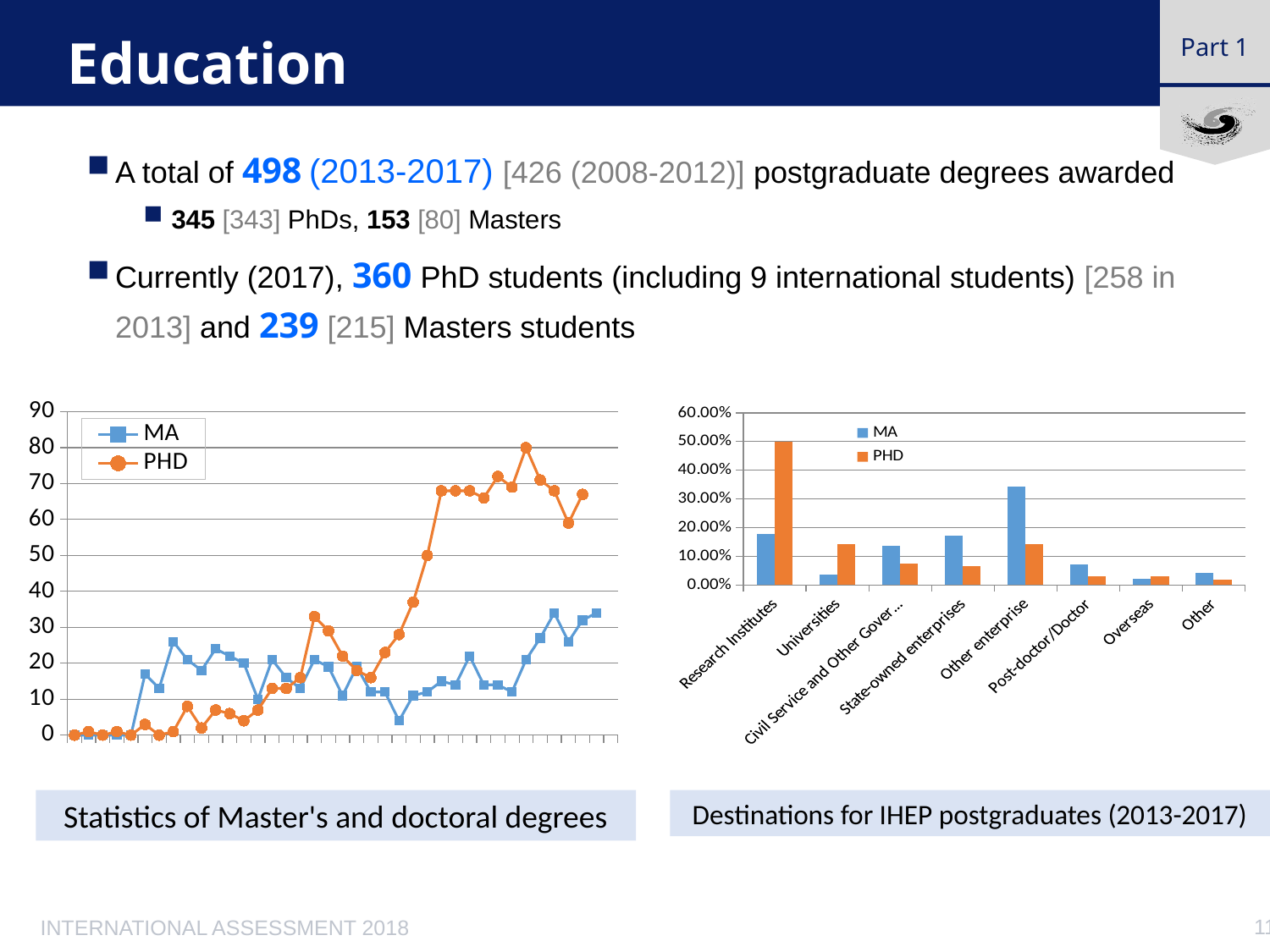
What kind of chart is the chart titled 'Destinations for IHEP postgraduates (2013-2017)'? bar chart In the chart 'Destinations for IHEP postgraduates (2013-2017)', for Research Institutes, which series has the larger value, MA or PHD? PHD In the chart 'Destinations for IHEP postgraduates (2013-2017)', is the MA value for Other enterprise greater or less than 30.00%? greater In the chart 'Destinations for IHEP postgraduates (2013-2017)', for Other enterprise, which series has the larger value, MA or PHD? MA In the chart 'Statistics of Master's and doctoral degrees', do the PHD values generally rise or fall along the x axis? rise In the chart 'Statistics of Master's and doctoral degrees', how many series does the legend list? 2 In the chart 'Destinations for IHEP postgraduates (2013-2017)', is the PHD value for Research Institutes greater or less than 40.00%? greater In the chart 'Destinations for IHEP postgraduates (2013-2017)', which category has the highest PHD value? Research Institutes In the chart 'Destinations for IHEP postgraduates (2013-2017)', how many destination categories are shown on the x axis? 8 In the chart 'Statistics of Master's and doctoral degrees', is the highest PHD value greater or less than 70? greater What kind of chart is the chart titled 'Statistics of Master's and doctoral degrees'? line chart In the chart 'Destinations for IHEP postgraduates (2013-2017)', which category has the highest MA value? Other enterprise